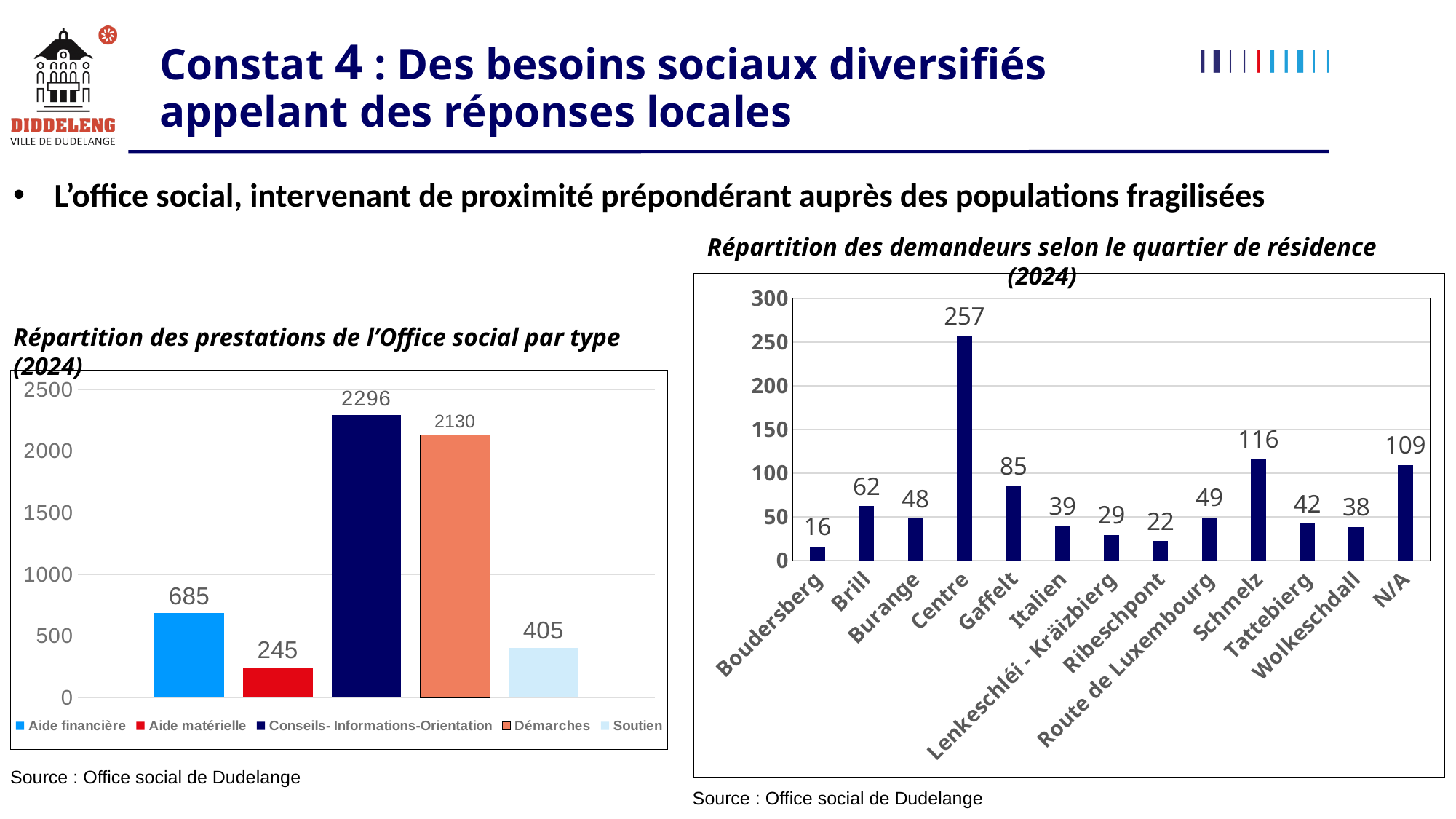
In the chart 'Répartition des demandeurs selon le quartier de résidence (2024)', which quartier has the highest value? Centre In the chart 'Répartition des prestations de l'Office social par type (2024)', which category has the lowest value? Aide matérielle What kind of chart is 'Répartition des demandeurs selon le quartier de résidence (2024)'? Bar chart In the chart 'Répartition des demandeurs selon le quartier de résidence (2024)', which quartier has the lowest value? Boudersberg In the chart 'Répartition des prestations de l'Office social par type (2024)', what is the difference between Conseils- Informations-Orientation and Démarches? 166 In the chart 'Répartition des prestations de l'Office social par type (2024)', what is the value for Aide financière? 685 In the chart 'Répartition des prestations de l'Office social par type (2024)', how many categories does the legend list? 5 In the chart 'Répartition des demandeurs selon le quartier de résidence (2024)', what is the difference between Centre and Gaffelt? 172 In the chart 'Répartition des prestations de l'Office social par type (2024)', which category has the highest value? Conseils- Informations-Orientation In the chart 'Répartition des prestations de l'Office social par type (2024)', which is larger: Soutien or Aide matérielle? Soutien In the chart 'Répartition des demandeurs selon le quartier de résidence (2024)', how many categories are shown on the x axis? 13 In the chart 'Répartition des demandeurs selon le quartier de résidence (2024)', what is the value for Schmelz? 116